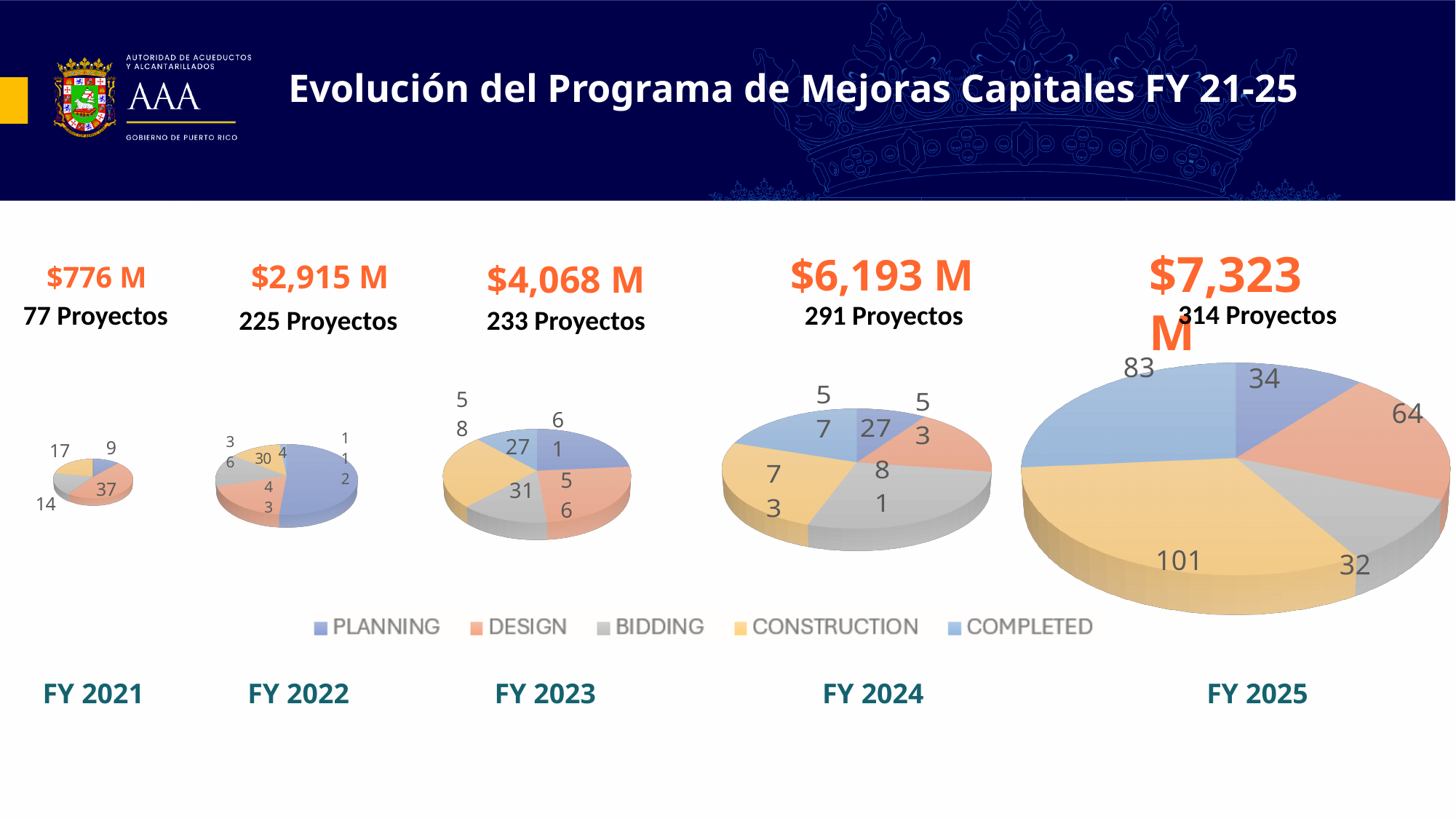
In the FY 2025 pie chart, what is the value for DESIGN? 64 In the FY 2022 pie chart, what is the value for BIDDING? 36 What kind of chart is used for FY 2025? Pie chart In the FY 2021 pie chart, what is the value for DESIGN? 37 How many series does the legend list? 5 In the FY 2025 pie chart, which is larger, PLANNING or DESIGN? DESIGN In the FY 2025 pie chart, what is the difference between the COMPLETED value and the BIDDING value? 51 How many pie charts are shown on the slide? 5 In the FY 2025 pie chart, which category has the largest slice? CONSTRUCTION In the FY 2021 pie chart, which category has the smallest labelled slice? PLANNING In the FY 2025 pie chart, what is the value for CONSTRUCTION? 101 In the FY 2021 pie chart, what is the difference between the CONSTRUCTION value and the BIDDING value? 3